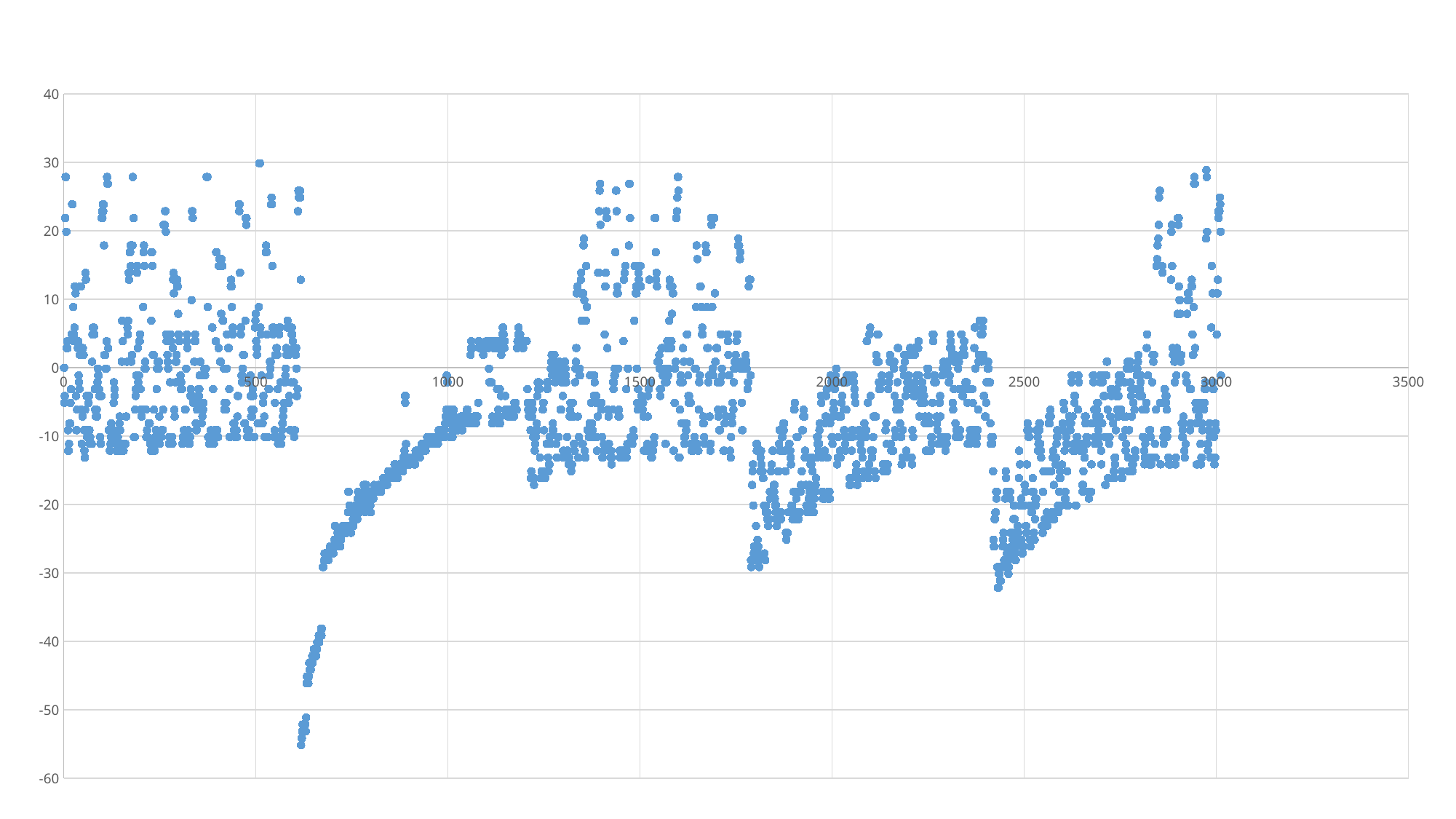
What is the highest value shown on the vertical axis? 40 Are the lowest points plotted near x = 2400 greater or less than -20? less Are the points plotted just below x = 650 greater or less than -30? less What kind of chart is shown on the slide? scatter chart Is the lowest plotted point greater or less than -50? less What is the lowest value shown on the vertical axis? -60 What colour are the plotted points? blue